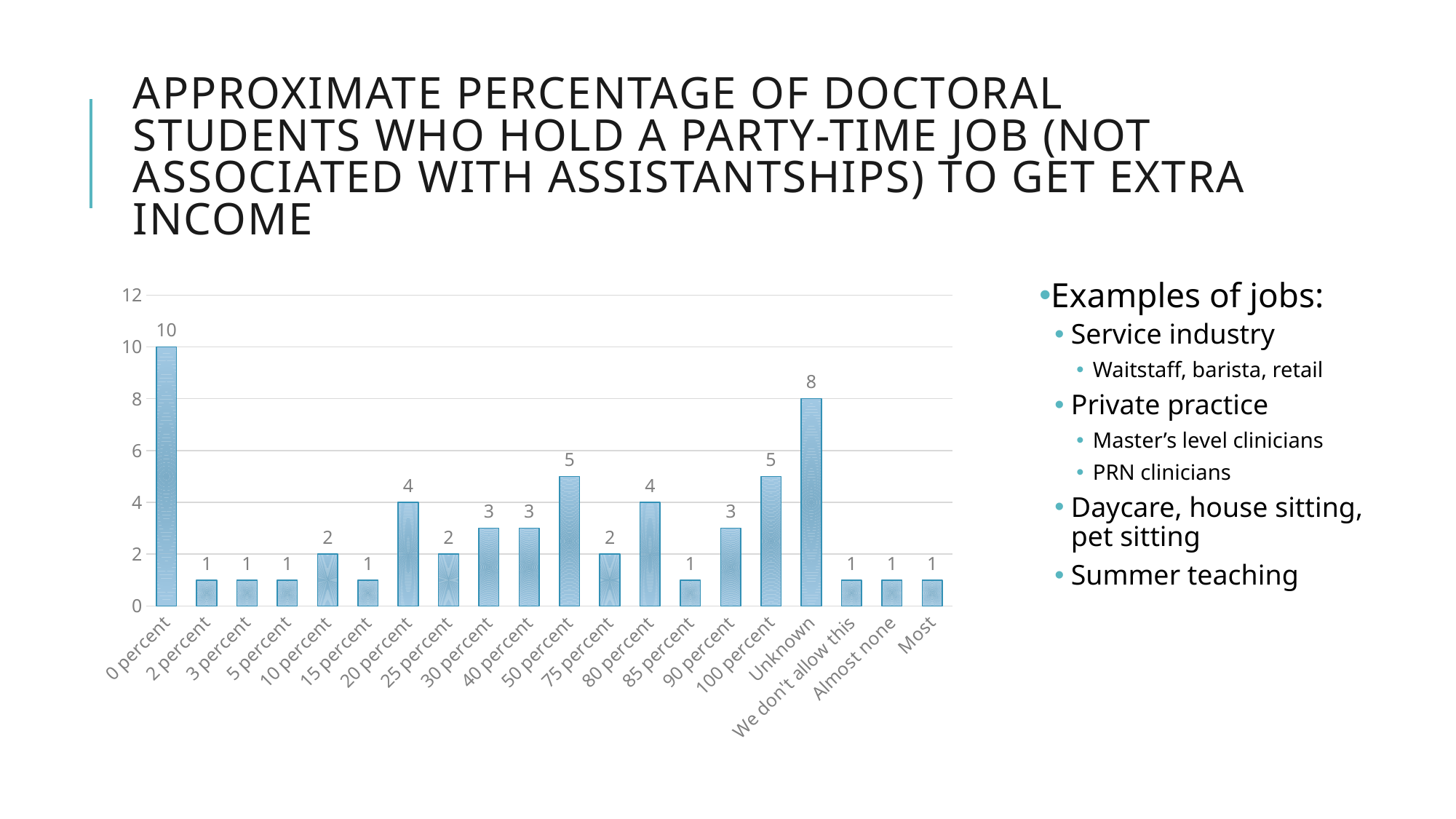
What is the value for the 50 percent category? 5 Is the value for Unknown greater or less than 6? greater What is the value for the Unknown category? 8 Which has a larger value, 80 percent or 90 percent? 80 percent How many categories are shown on the x axis of the chart? 20 What is the value for the 100 percent category? 5 Which category has the highest value? 0 percent What is the difference between the values for 0 percent and Unknown? 2 What kind of chart is shown on the slide? bar chart What is the difference between the values for 50 percent and 75 percent? 3 What is the value for the 0 percent category? 10 What is the value for the 20 percent category? 4